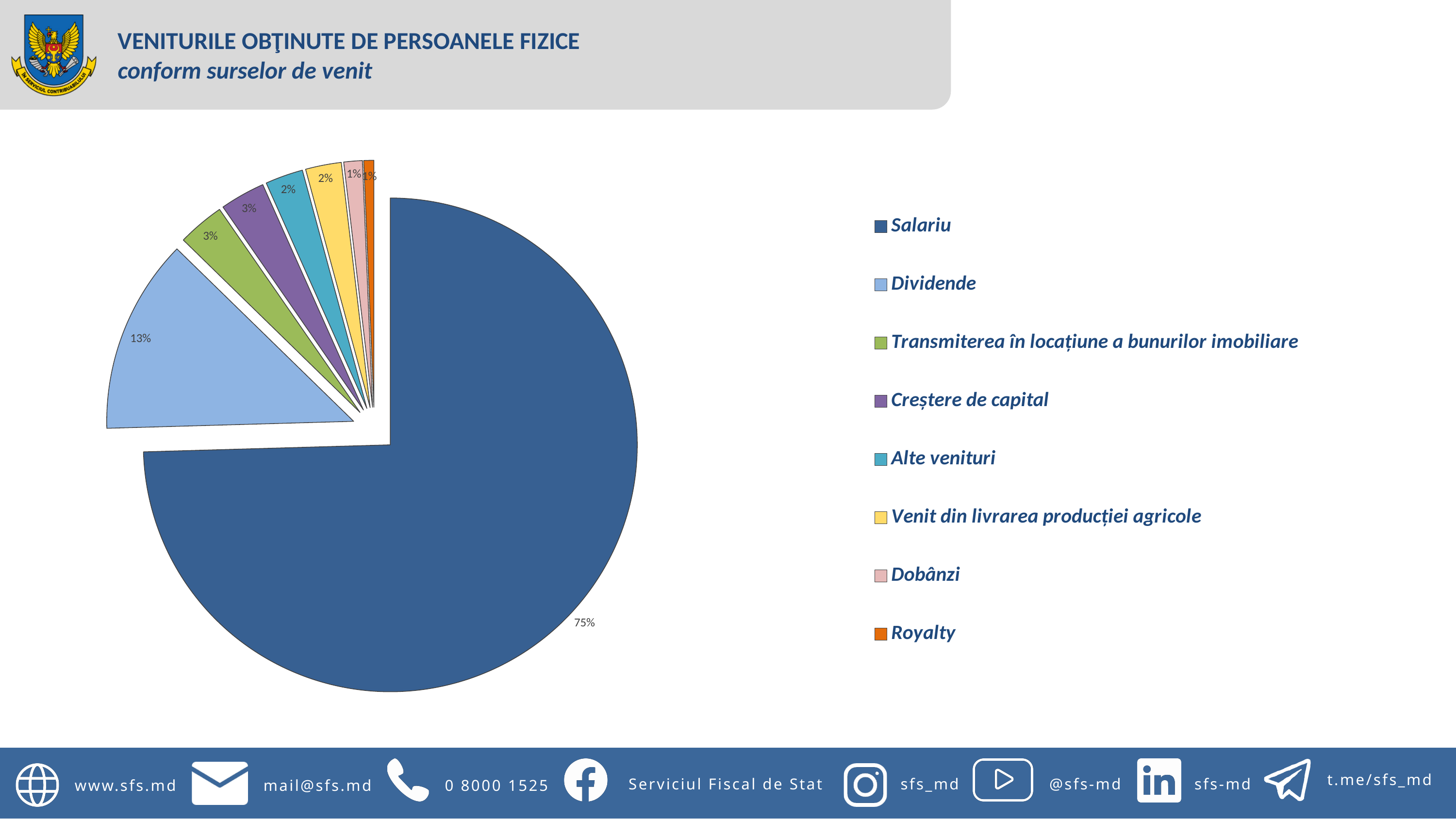
What is the value shown for Alte venituri? 2% What type of chart is shown on the slide? Pie chart What share of the pie does Salariu represent? 75% Which is larger, the share for Dividende or the share for Creștere de capital? Dividende What is the value shown for Dividende? 13% How many slices does the pie chart have? 8 What is the value shown for Creștere de capital? 3% Which income source has the largest share of the pie? Salariu What is the value shown for Royalty? 1% What is the title of the slide? VENITURILE OBŢINUTE DE PERSOANELE FIZICE conform surselor de venit What is the difference in percentage points between Salariu and Dividende? 62 How many entries does the legend list? 8